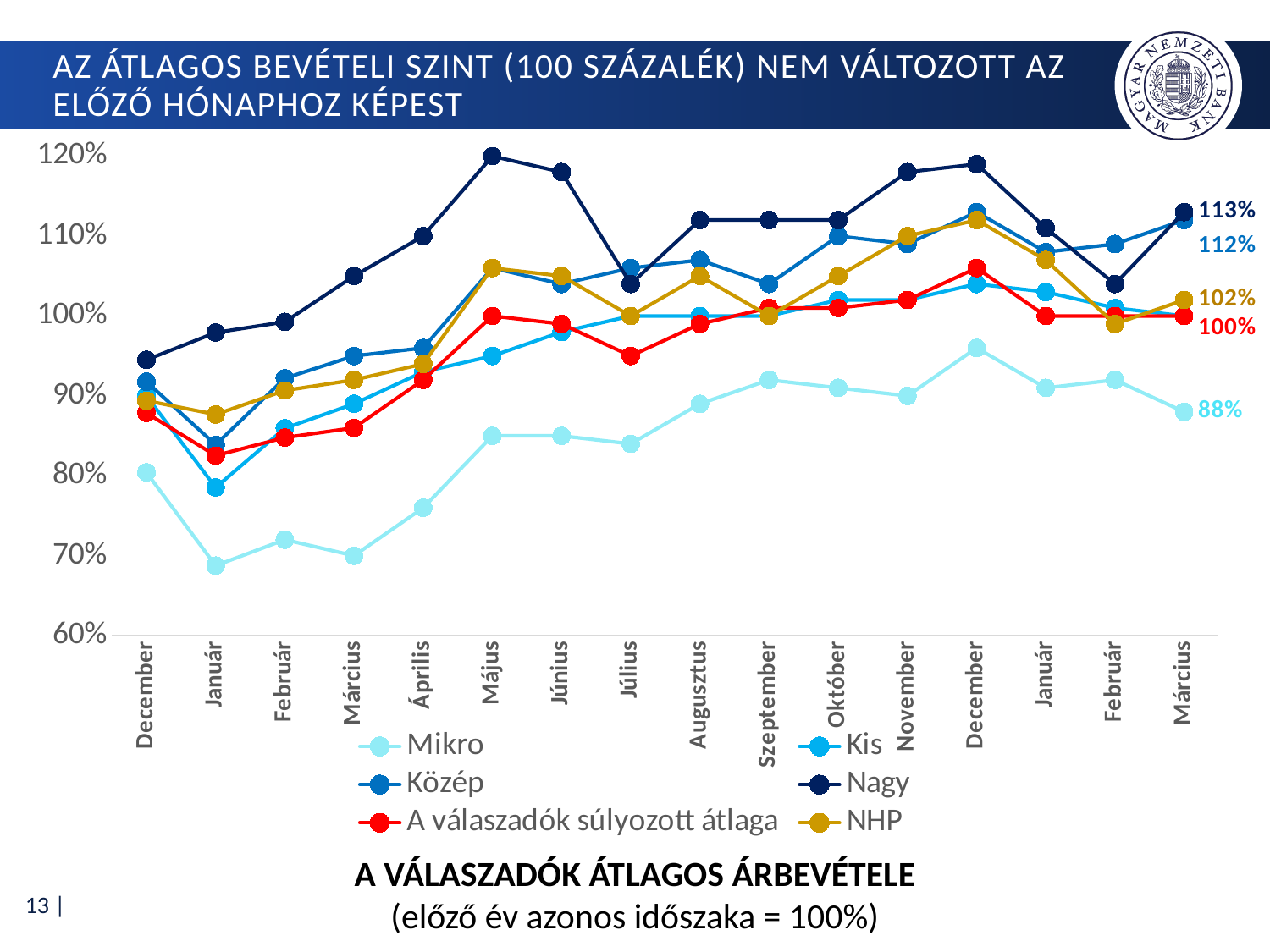
Does the Mikro series rise or fall from the first December to the first Január? fall At the final Március point, what is the difference between the Nagy value and the Mikro value? 25 percentage points What is the value of 'A válaszadók súlyozott átlaga' at the final Március point? 100% What is the value of the Közép series at the final Március point? 112% What is the value of the Nagy series at the final Március point? 113% Is the value of the Nagy series in Május greater or less than 110%? greater What is the value of the Mikro series at the final Március point? 88% How many series does the legend list? 6 What kind of chart is shown on the slide? line chart How many months are shown along the x axis? 16 What is the value of the NHP series at the final Március point? 102% Which series has the lowest value at the final Március point? Mikro